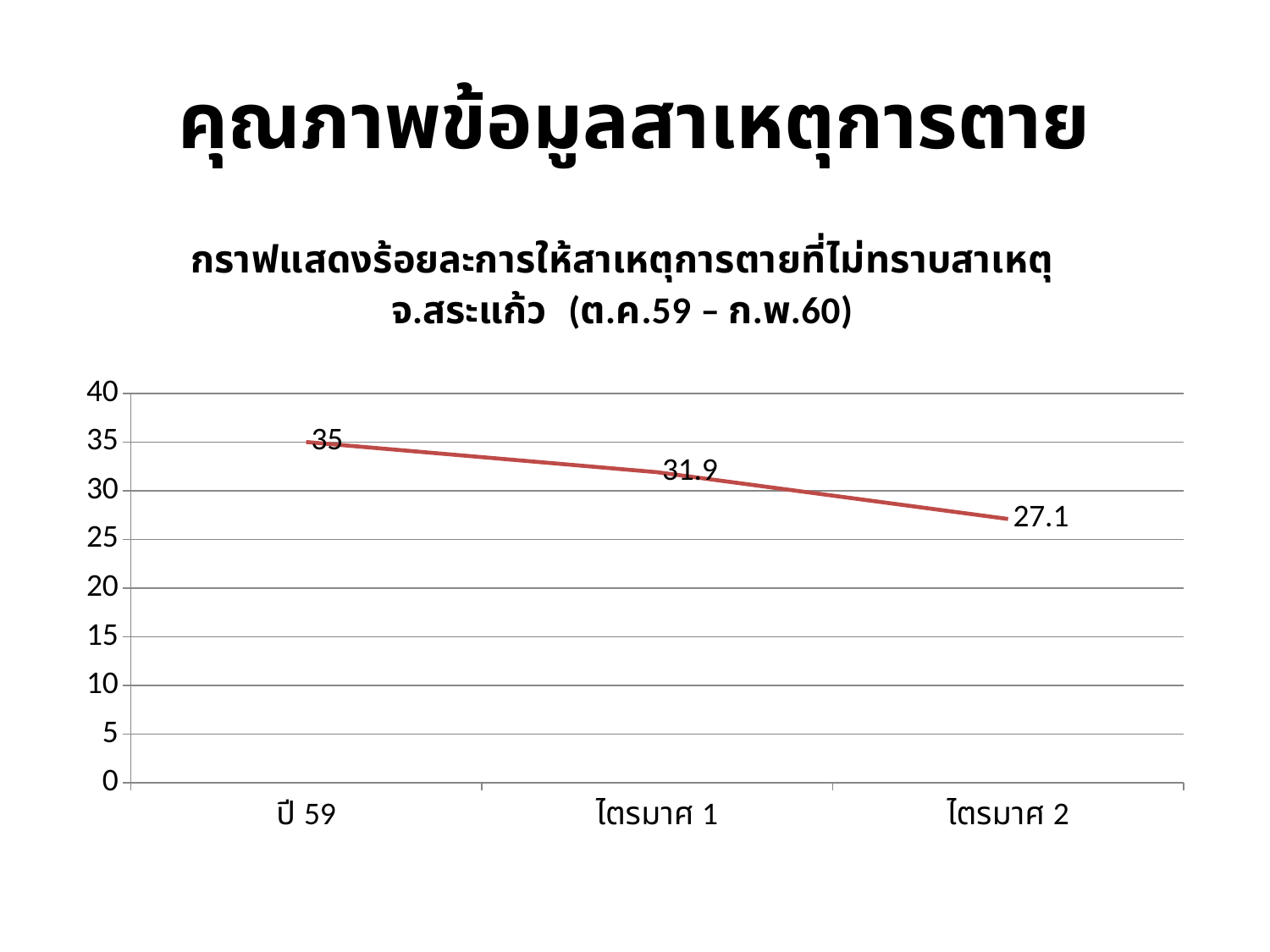
What kind of chart is shown on the slide? line chart What is the value for ไตรมาศ 2? 27.1 Which is larger, the value for ปี 59 or the value for ไตรมาศ 1? ปี 59 What is the difference between the values for ปี 59 and ไตรมาศ 2? 7.9 What is the difference between the values for ไตรมาศ 1 and ไตรมาศ 2? 4.8 Do the values rise or fall from ปี 59 to ไตรมาศ 2? fall Which category has the highest value? ปี 59 Is the value for ไตรมาศ 2 greater or less than 30? less Which category has the lowest value? ไตรมาศ 2 How many categories are plotted on the x axis? 3 What is the value for ไตรมาศ 1? 31.9 What is the value for ปี 59? 35